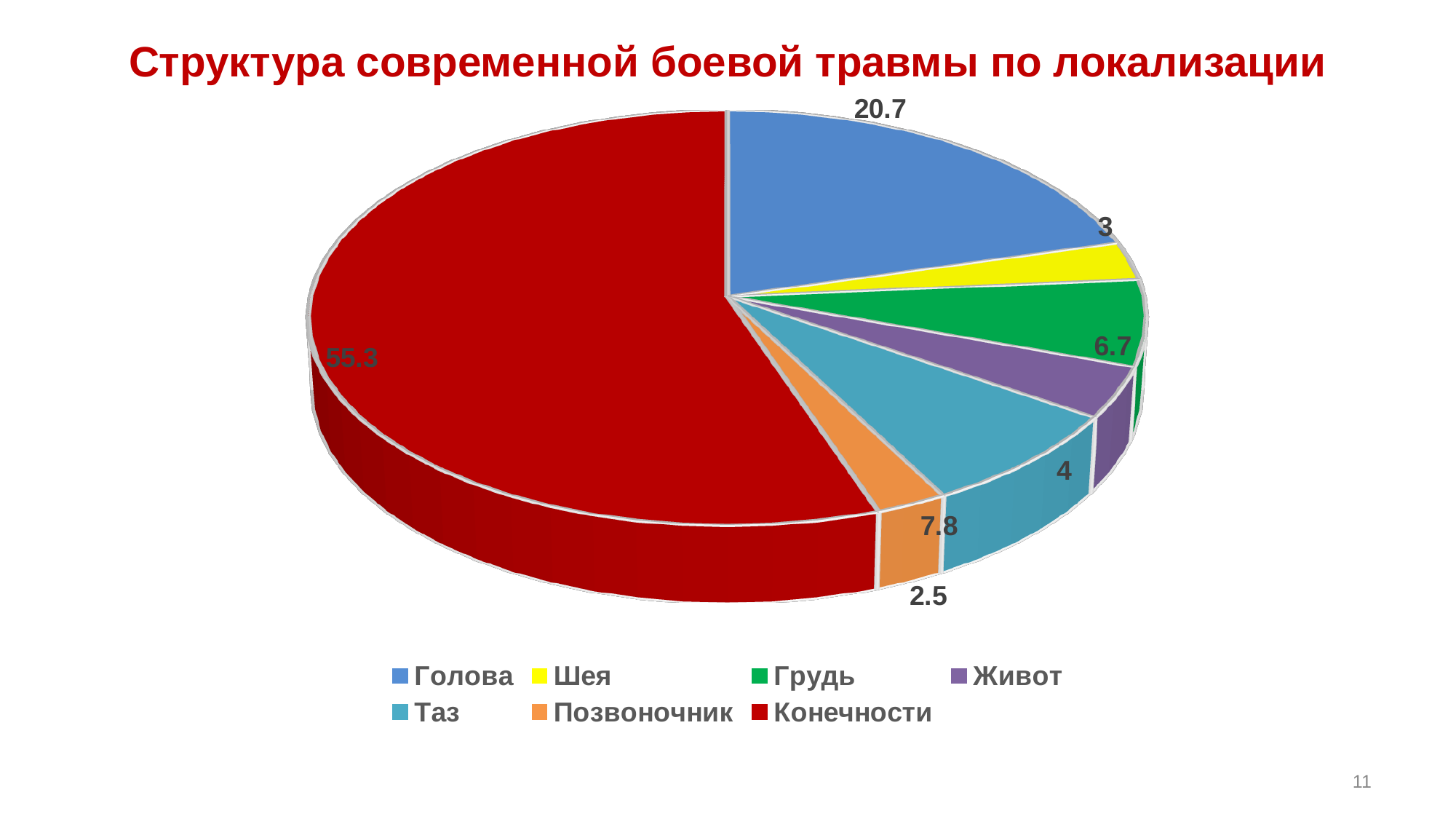
What is the value for Голова? 20.7 What is the value for Шея? 3 What is the value for Конечности? 55.3 How many categories does the pie chart have? 7 What kind of chart is shown on the slide? pie chart What is the title of the chart? Структура современной боевой травмы по локализации Which category has the largest slice? Конечности Which is larger, the value for Таз or the value for Живот? Таз What is the value for Позвоночник? 2.5 Which category has the smallest slice? Позвоночник What is the difference between the values for Конечности and Голова? 34.6 What is the value for Грудь? 6.7